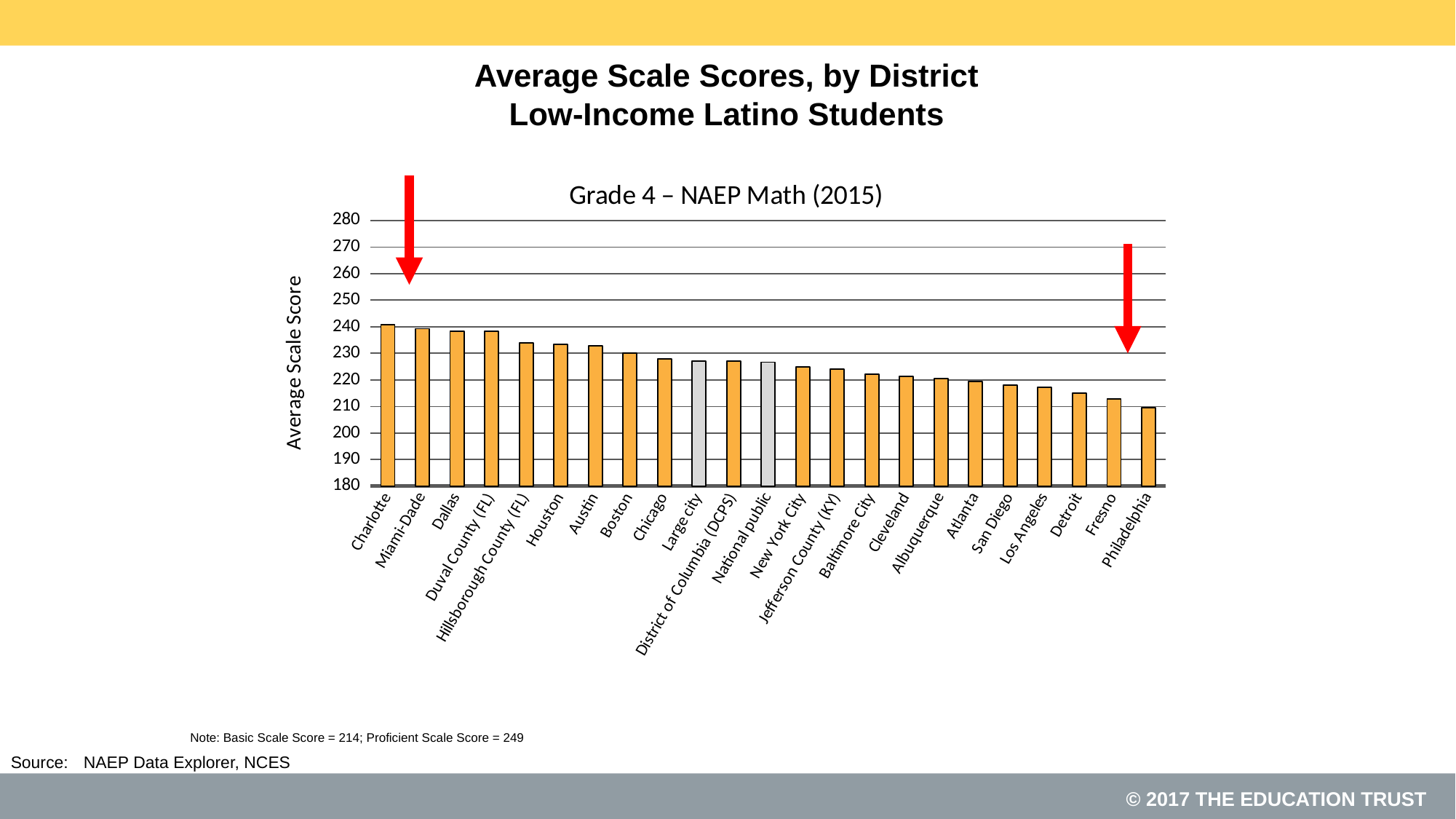
What kind of chart is shown on the slide? bar chart How many districts/categories are plotted along the x axis? 23 Do the values rise or fall moving from left to right along the x axis? fall Which category has the highest average scale score? Charlotte What is the title printed above the chart's plot area? Grade 4 – NAEP Math (2015) Which is larger, the value for Houston or the value for Detroit? Houston Is the value for Detroit greater or less than 220? less Is the value for Houston greater or less than 230? greater Is the value for Philadelphia greater or less than 220? less Which category has the lowest average scale score? Philadelphia Which two categories are shown with grey bars instead of orange? Large city and National public